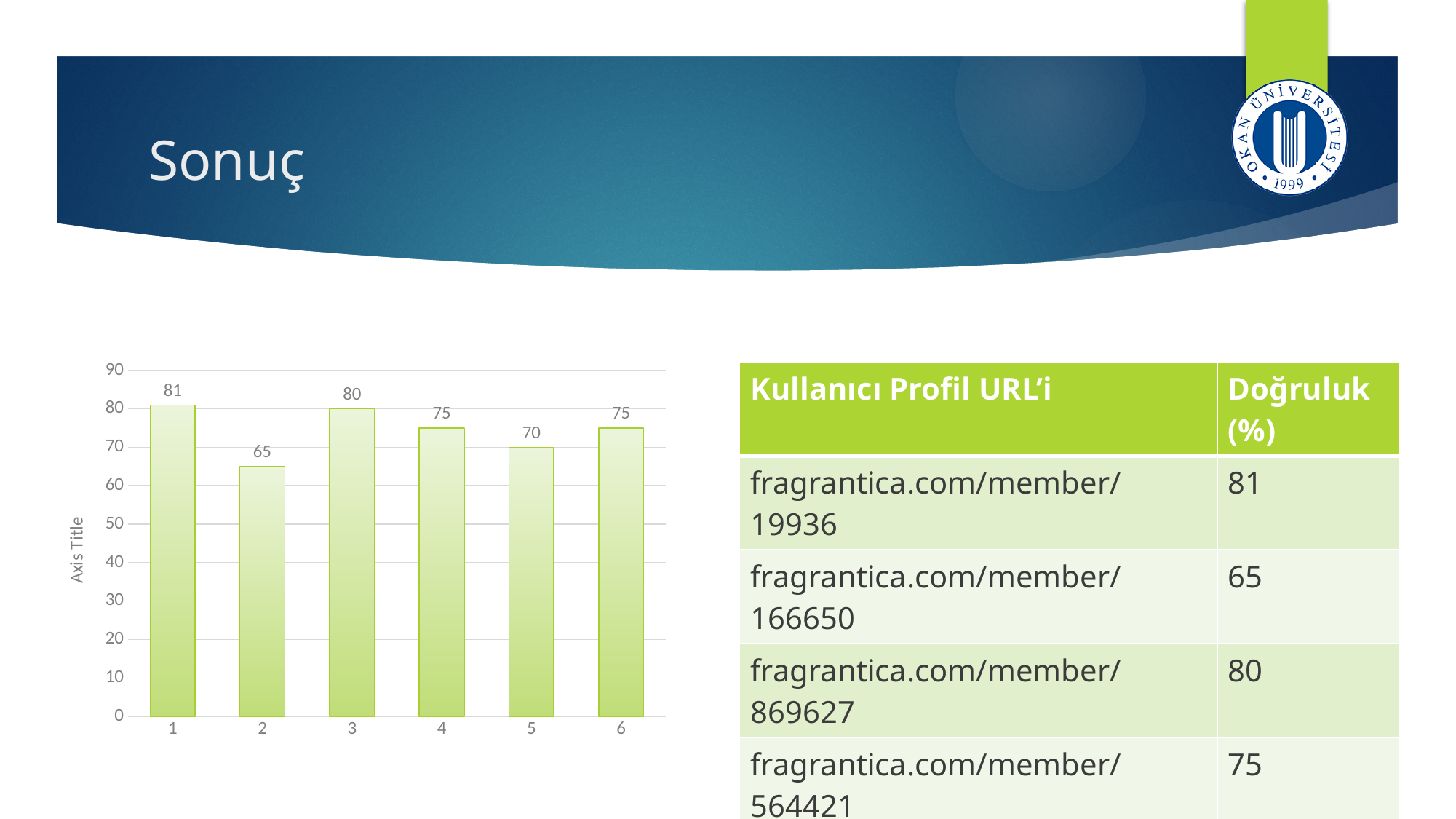
What is the value of the bar for category 5? 70 What is the highest tick value shown on the vertical axis? 90 What is the label on the vertical axis of the chart? Axis Title What is the value of the bar for category 1? 81 How many bars are shown in the chart? 6 What is the difference between the values for category 1 and category 2? 16 What type of chart is shown on the slide? bar chart Which category has the highest bar? 1 Which is larger, the value for category 3 or the value for category 4? category 3 Which category has the lowest bar? 2 Is the value for category 5 greater or less than 60? greater What is the value of the bar for category 2? 65